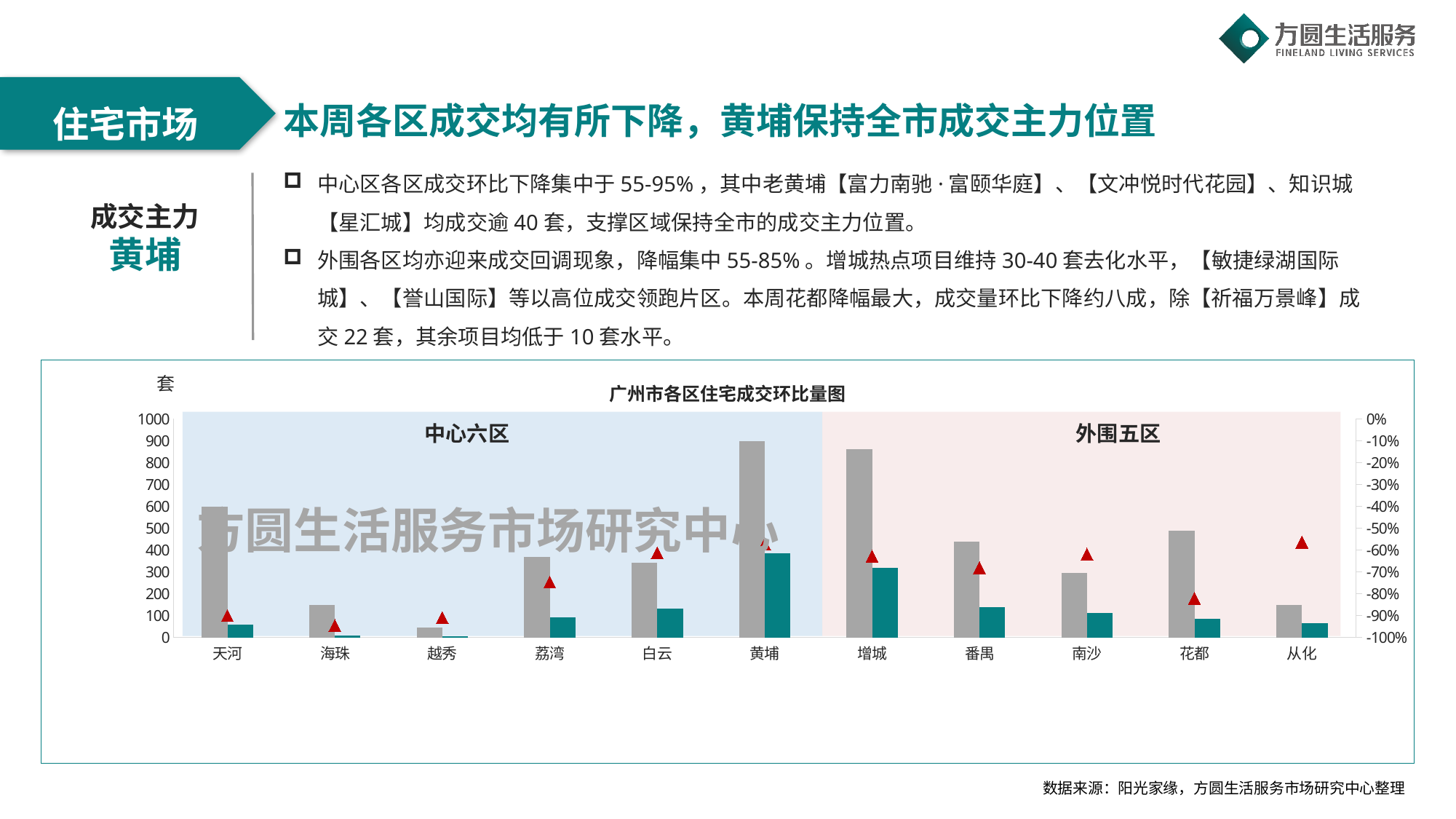
Which district has the larger gray bar, 荔湾 or 海珠? 荔湾 How many districts are shown along the x axis of the chart? 11 What is the title of the chart? 广州市各区住宅成交环比量图 Is the teal bar for 海珠 greater or less than 100? less What unit is shown at the top of the left axis of the chart? 套 Is the gray bar for 从化 greater or less than 100? greater Which district has the larger teal bar, 增城 or 番禺? 增城 Which district has the tallest teal bar in the chart? 黄埔 Is the gray bar for 番禺 greater or less than 400? greater What kind of chart is shown on the slide? bar chart Which district has the shortest gray bar in the chart? 越秀